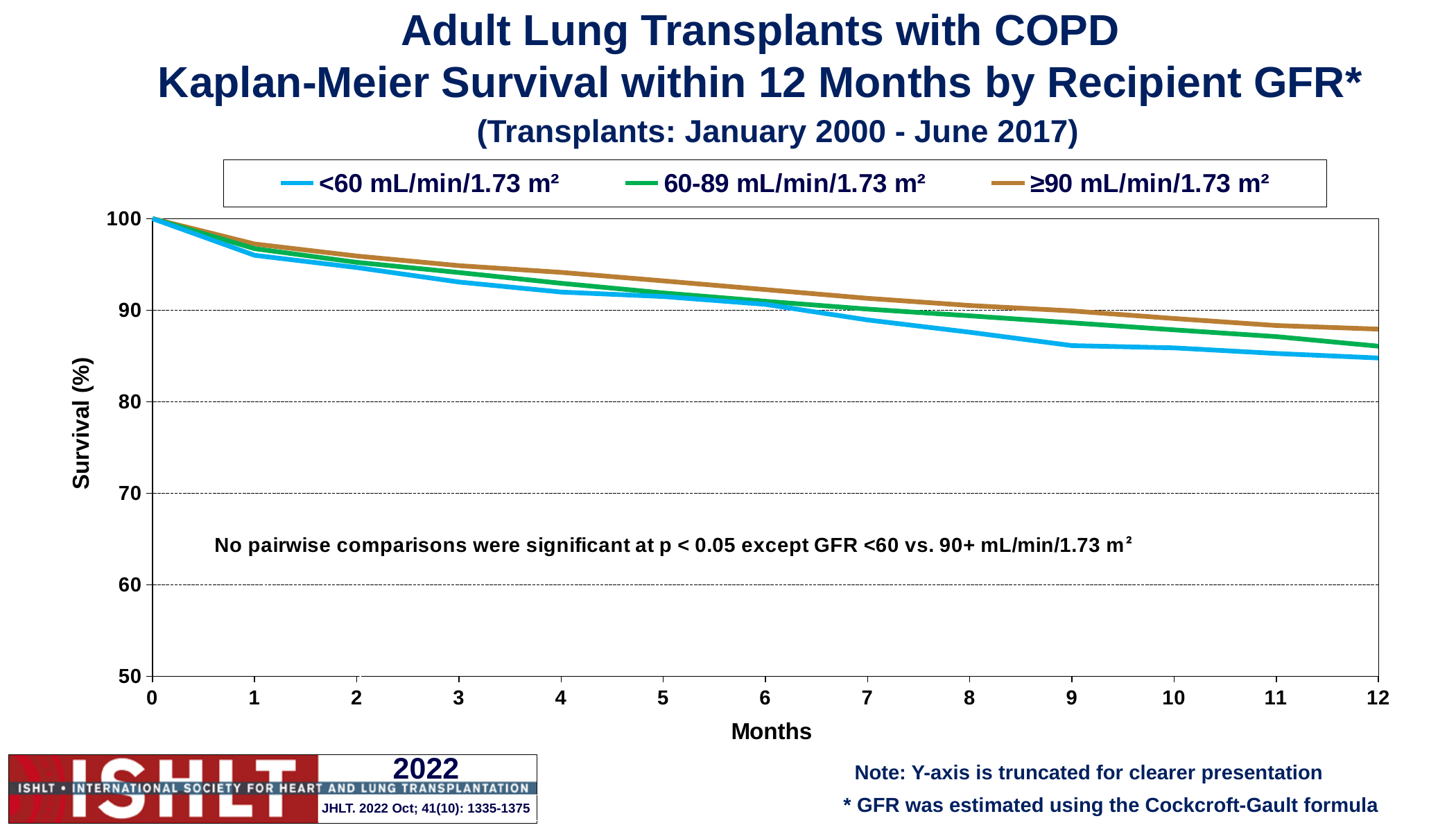
How many series does the legend list? 3 Is the survival value for the ≥90 mL/min/1.73 m² group at month 6 greater or less than 90? greater Is the survival value for the <60 mL/min/1.73 m² group at month 3 greater or less than 90? greater Which group has the lowest survival at month 12? <60 mL/min/1.73 m² At month 12, which group has higher survival: <60 mL/min/1.73 m² or ≥90 mL/min/1.73 m²? ≥90 mL/min/1.73 m² What is the survival value for the <60 mL/min/1.73 m² group at month 0? 100 Is the survival value for the <60 mL/min/1.73 m² group at month 9 greater or less than 90? less What is the label of the x axis? Months What kind of chart is shown on the slide? line chart Do the survival values rise or fall as months increase along the x axis? fall